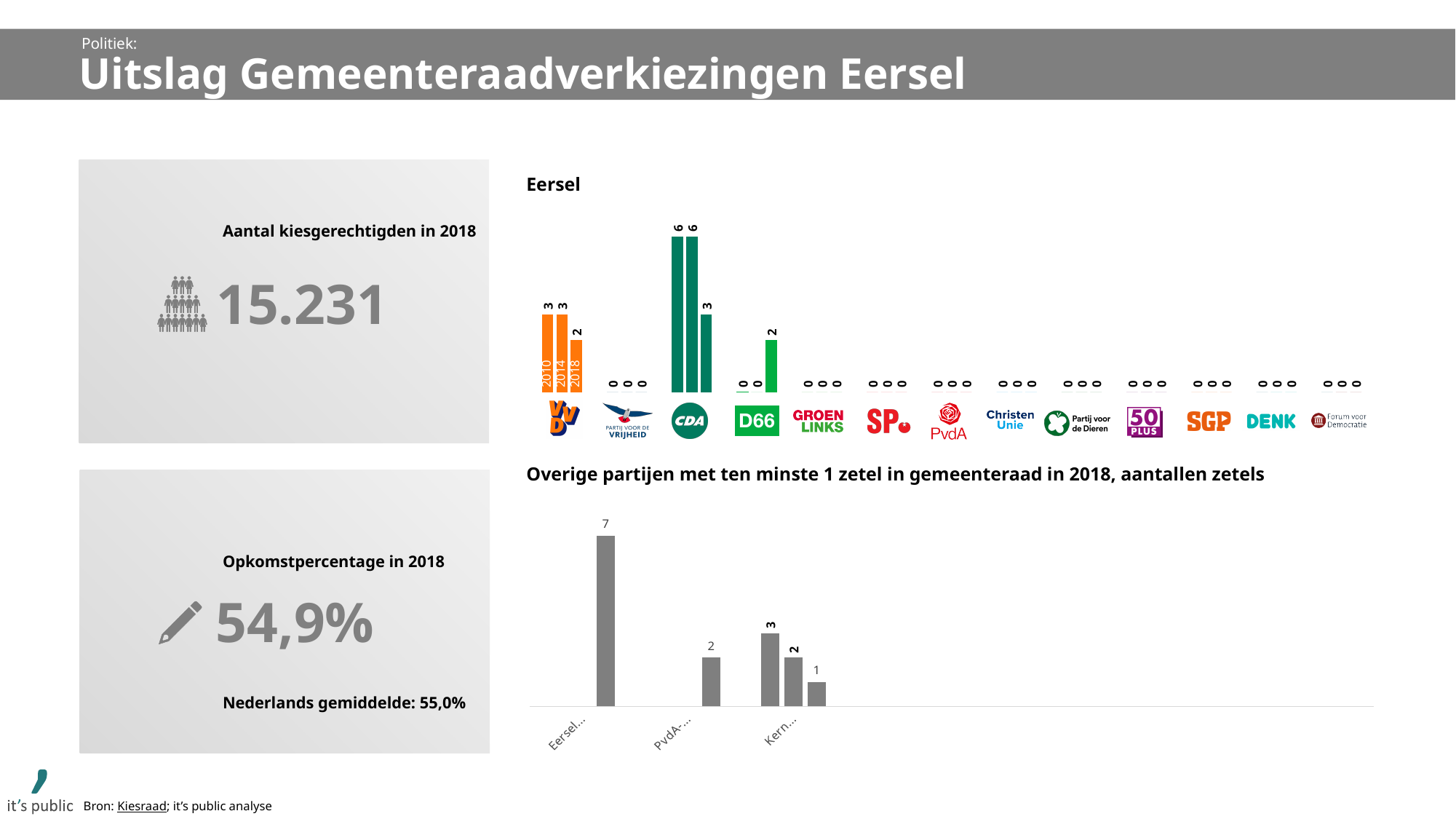
In the 'Eersel' chart, how many seats did D66 have in 2018? 2 In the 'Eersel' chart, did CDA's seats rise or fall from 2014 to 2018? fall In the 'Overige partijen met ten minste 1 zetel in gemeenteraad in 2018' chart, how many bars are plotted? 5 In the 'Overige partijen met ten minste 1 zetel in gemeenteraad in 2018' chart, what is the highest value shown? 7 In the 'Eersel' chart, how many seats did VVD have in 2018? 2 In the 'Eersel' chart, how many seats did CDA have in 2010? 6 What kind of chart is the 'Overige partijen met ten minste 1 zetel in gemeenteraad in 2018' chart? bar chart In the 'Eersel' chart, what is the difference between CDA's seats in 2014 and 2018? 3 In the 'Eersel' chart, how many seats did CDA have in 2018? 3 In the 'Eersel' chart, which party had the most seats in 2014? CDA In the 'Eersel' chart, how many years are shown for each party? 3 In the 'Eersel' chart, which had more seats in 2018, VVD or CDA? CDA